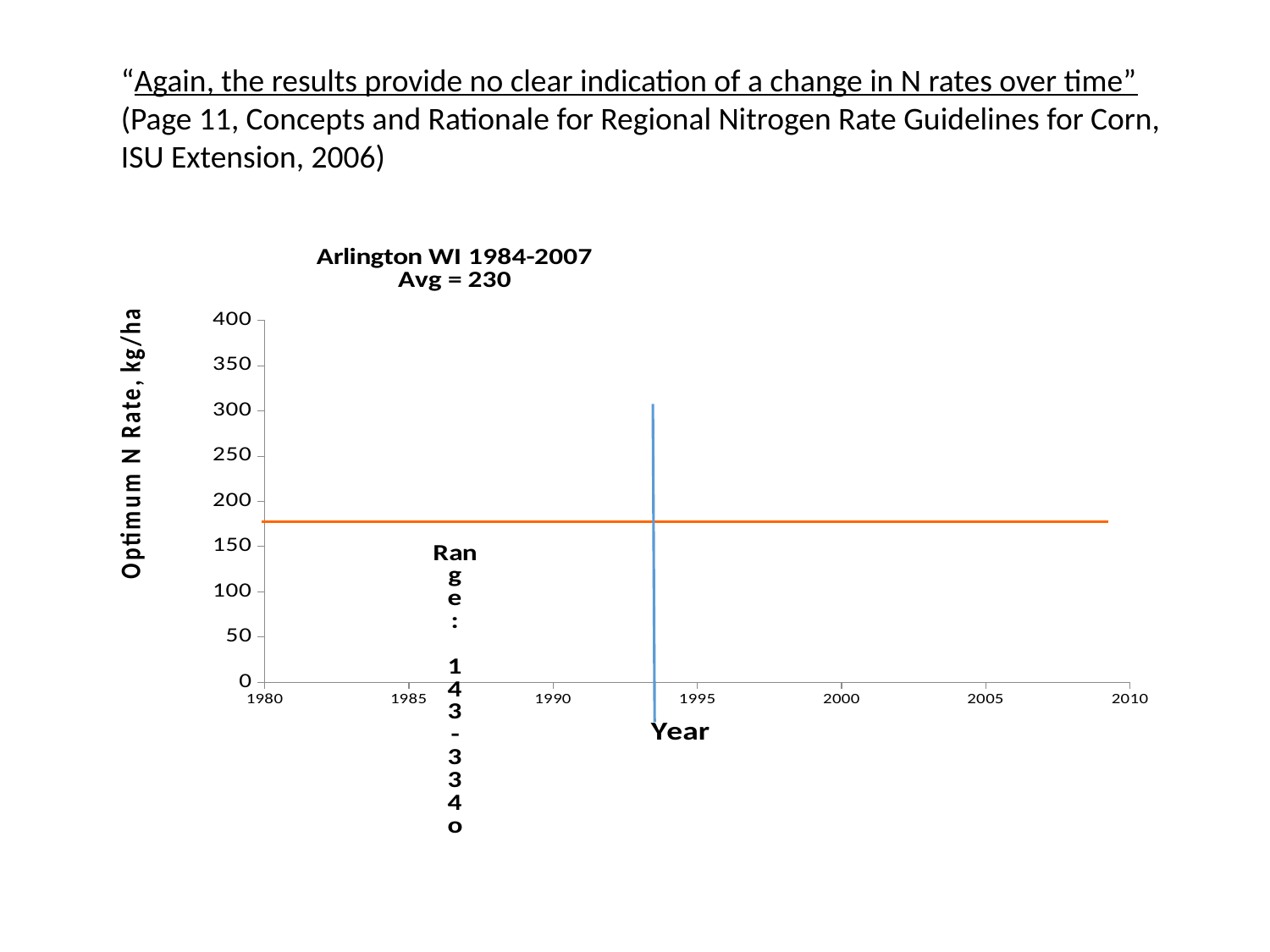
What is the title of the chart? Arlington WI 1984-2007 Avg = 230 Is the top of the vertical blue line greater or less than 350? less What is the highest value shown on the y axis? 400 What is the last year shown on the x axis? 2010 How many year tick labels are shown on the x axis? 7 What is the label of the horizontal (x) axis? Year What average value is stated in the chart title? 230 What is the first year shown on the x axis? 1980 Is the value of the horizontal orange line greater or less than 150? greater Is the value of the horizontal orange line greater or less than 200? less What is the label of the vertical (y) axis? Optimum N Rate, kg/ha What range of values is printed in the text annotation on the chart? 143-334